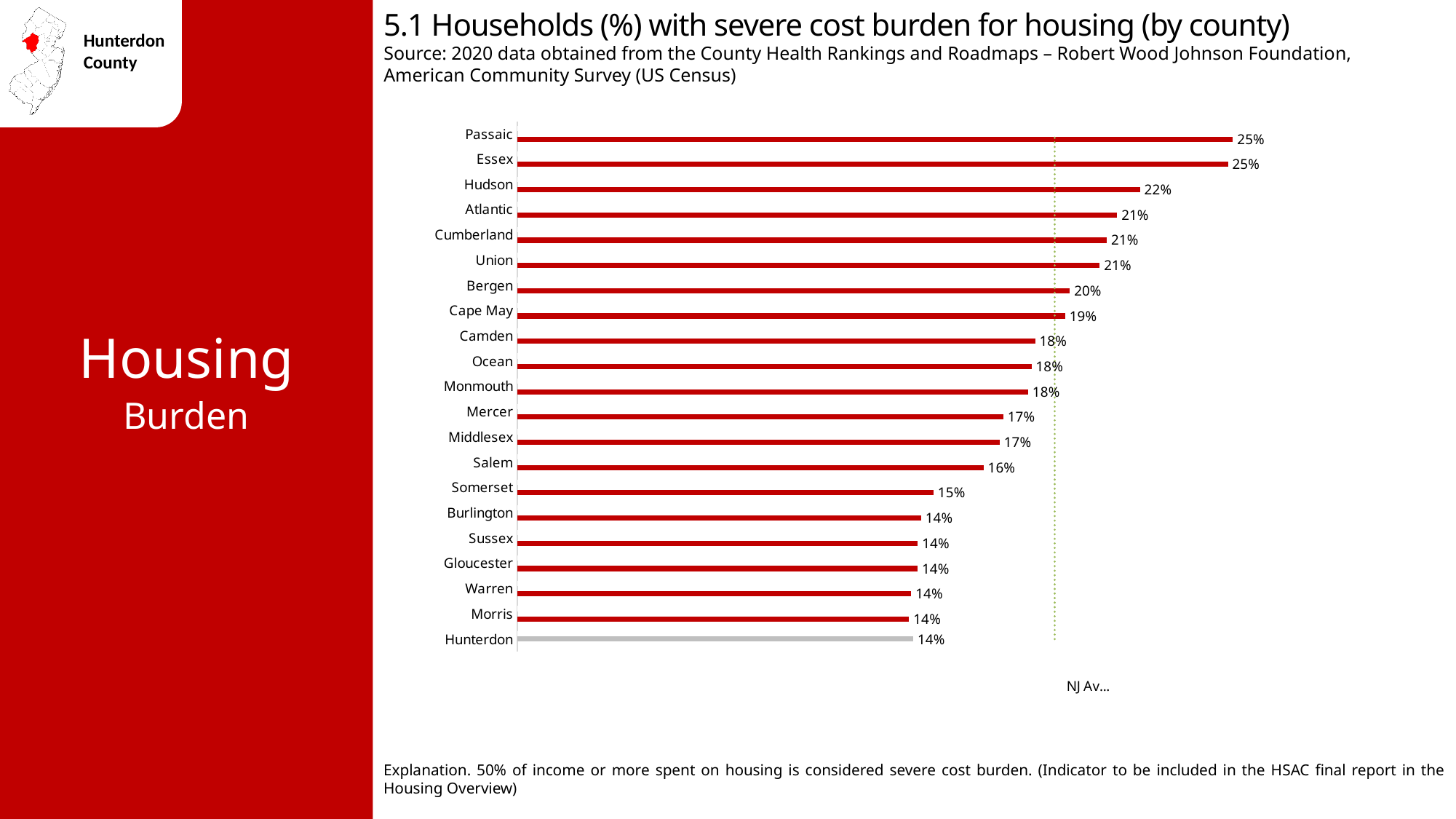
How many percentage points higher is Passaic's value than Hunterdon's? 11 percentage points What type of chart is used on this slide? Bar chart What percentage of households in Hudson County have a severe housing cost burden? 22% Which has a higher value, Hudson or Bergen? Hudson Which county's bar is drawn in grey rather than red? Hunterdon What is the value shown for Somerset? 15% What is the highest percentage shown on the chart? 25% What is the difference between the values for Hudson and Salem? 6 percentage points What is the lowest percentage shown on the chart? 14% What is the value shown for Hunterdon County? 14% What is the value shown for Cape May? 19% How many counties are shown on the chart? 21